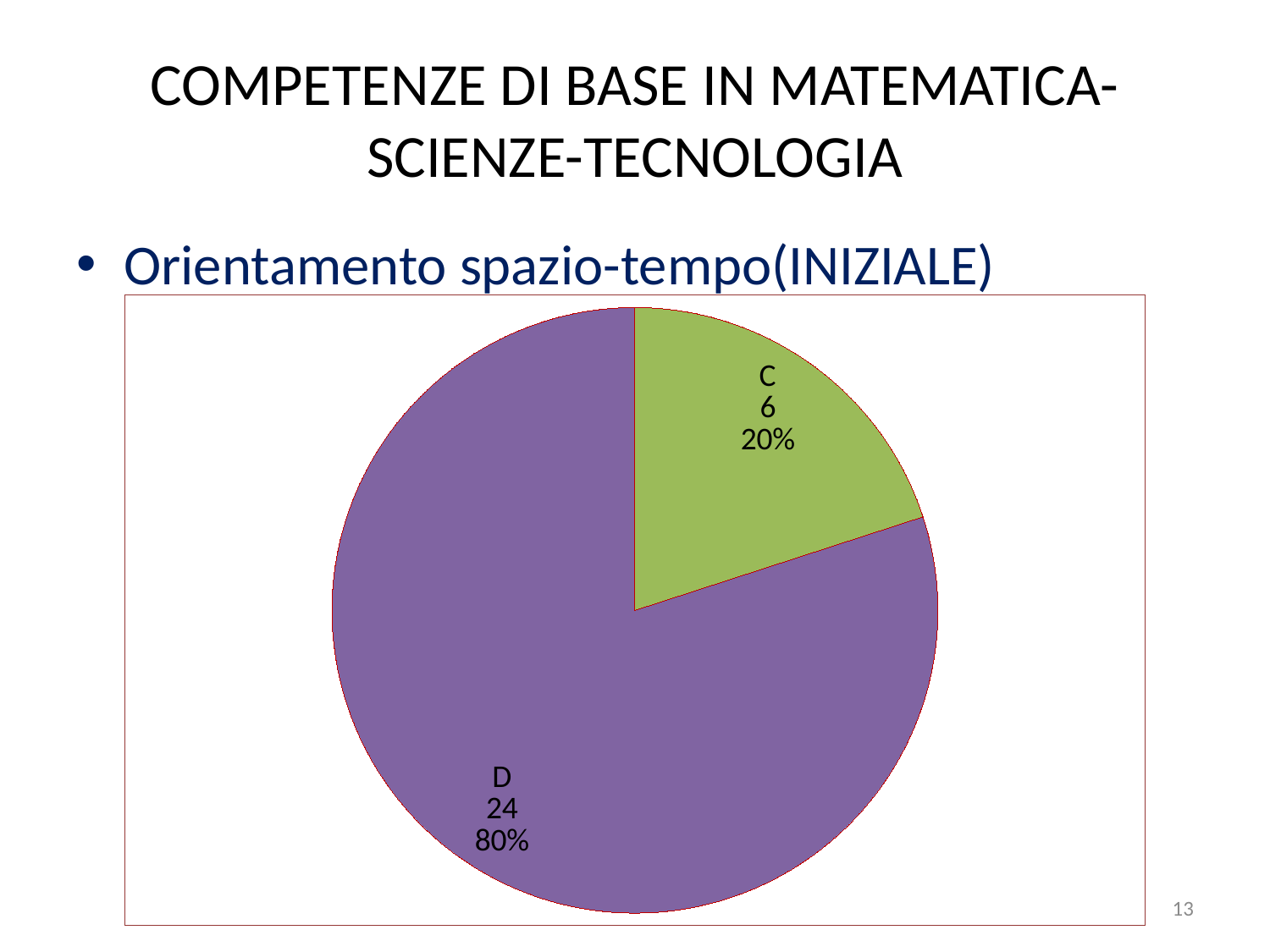
What is the difference between the values for D and C? 18 How many slices does the pie chart have? 2 What kind of chart is shown on the slide? pie chart What is the value for category C? 6 What is the value for category D? 24 What share of the pie does slice D represent? 80% Which category has the smallest slice? C Which category has the largest slice? D What colour is the slice for category C? green Which is larger, the value for C or the value for D? D What share of the pie does slice C represent? 20% What is the total of the values shown in the pie chart? 30